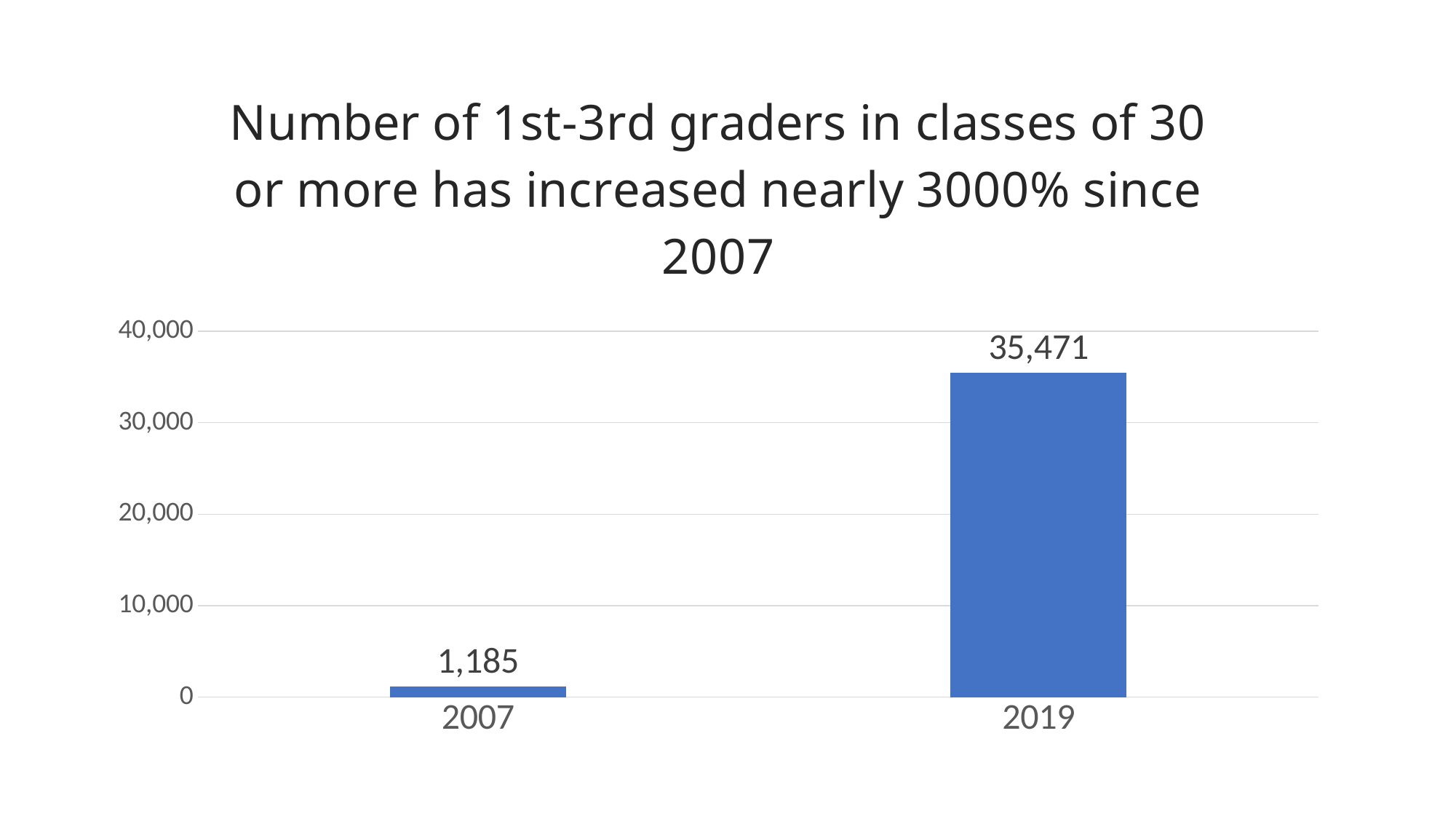
What is the value for 2019? 35,471 What is the title of the chart? Number of 1st-3rd graders in classes of 30 or more has increased nearly 3000% since 2007 How many categories are shown on the x axis? 2 Which year has the highest value? 2019 Is the value for 2007 greater or less than 10,000? less What is the difference between the values for 2019 and 2007? 34,286 Is the value for 2019 greater or less than 30,000? greater What is the value for 2007? 1,185 Do the values rise or fall from 2007 to 2019? rise Which is larger, the value for 2007 or the value for 2019? 2019 What kind of chart is shown on the slide? bar chart Which year has the lowest value? 2007